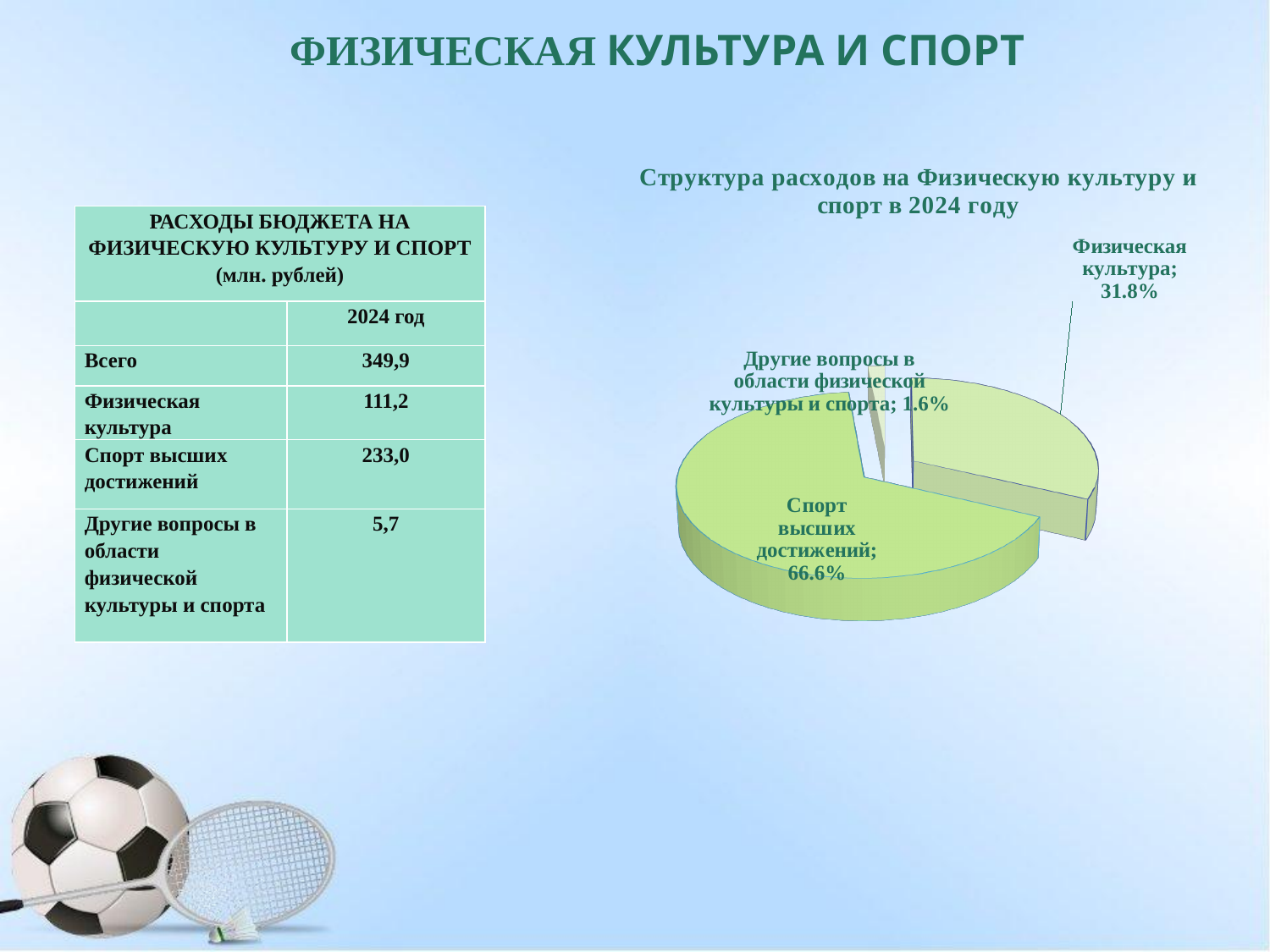
What share of the pie does Другие вопросы в области физической культуры и спорта have? 1.6% What share of the pie does Спорт высших достижений have? 66.6% Which slice of the pie chart is the smallest? Другие вопросы в области физической культуры и спорта Is the share of Физическая культура in the pie chart greater or less than 50%? less Which is larger in the pie chart: Физическая культура or Спорт высших достижений? Спорт высших достижений By how many percentage points does the share of Физическая культура exceed the share of Другие вопросы в области физической культуры и спорта? 30.2 By how many percentage points does the share of Спорт высших достижений exceed the share of Физическая культура? 34.8 What is the title of the pie chart? Структура расходов на Физическую культуру и спорт в 2024 году What share of the pie does Физическая культура have? 31.8% Which slice of the pie chart is the largest? Спорт высших достижений How many slices does the pie chart have? 3 What kind of chart is shown on the slide? pie chart